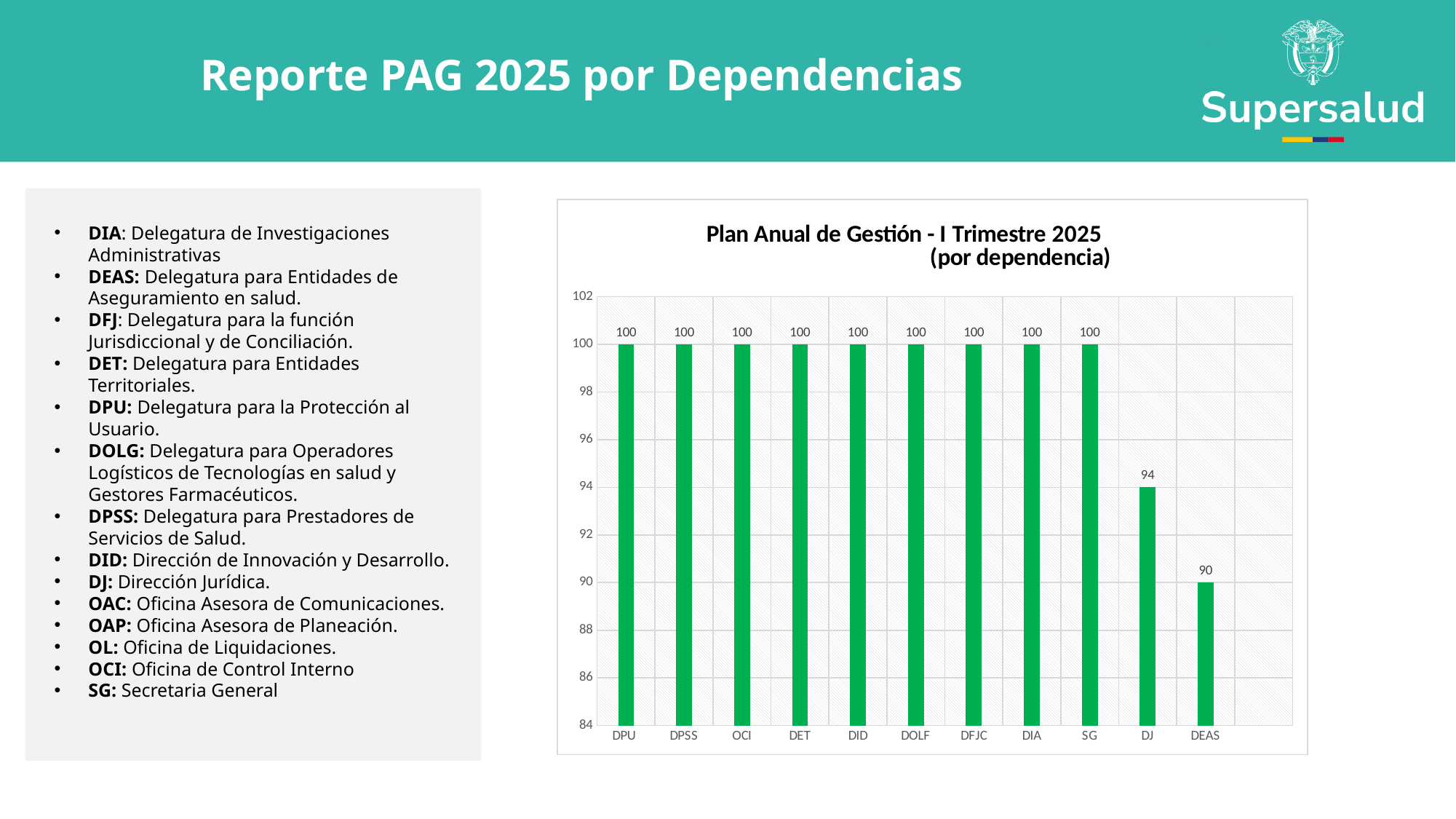
How many dependencies have a value of 100 in the chart? 9 What is the value for DEAS in the chart? 90 What kind of chart is shown on the slide? Bar chart What is the value for DPU in the chart? 100 How many dependencies are shown on the x axis of the chart? 11 Which is larger, the value for DJ or the value for DEAS? DJ What is the value for DJ in the chart? 94 Which dependency has the lowest value in the chart? DEAS What is the difference between the values for DJ and DEAS? 4 Is the value for DEAS greater or less than 92? less What is the difference between the values for SG and DJ? 6 What is the title of the chart? Plan Anual de Gestión - I Trimestre 2025 (por dependencia)